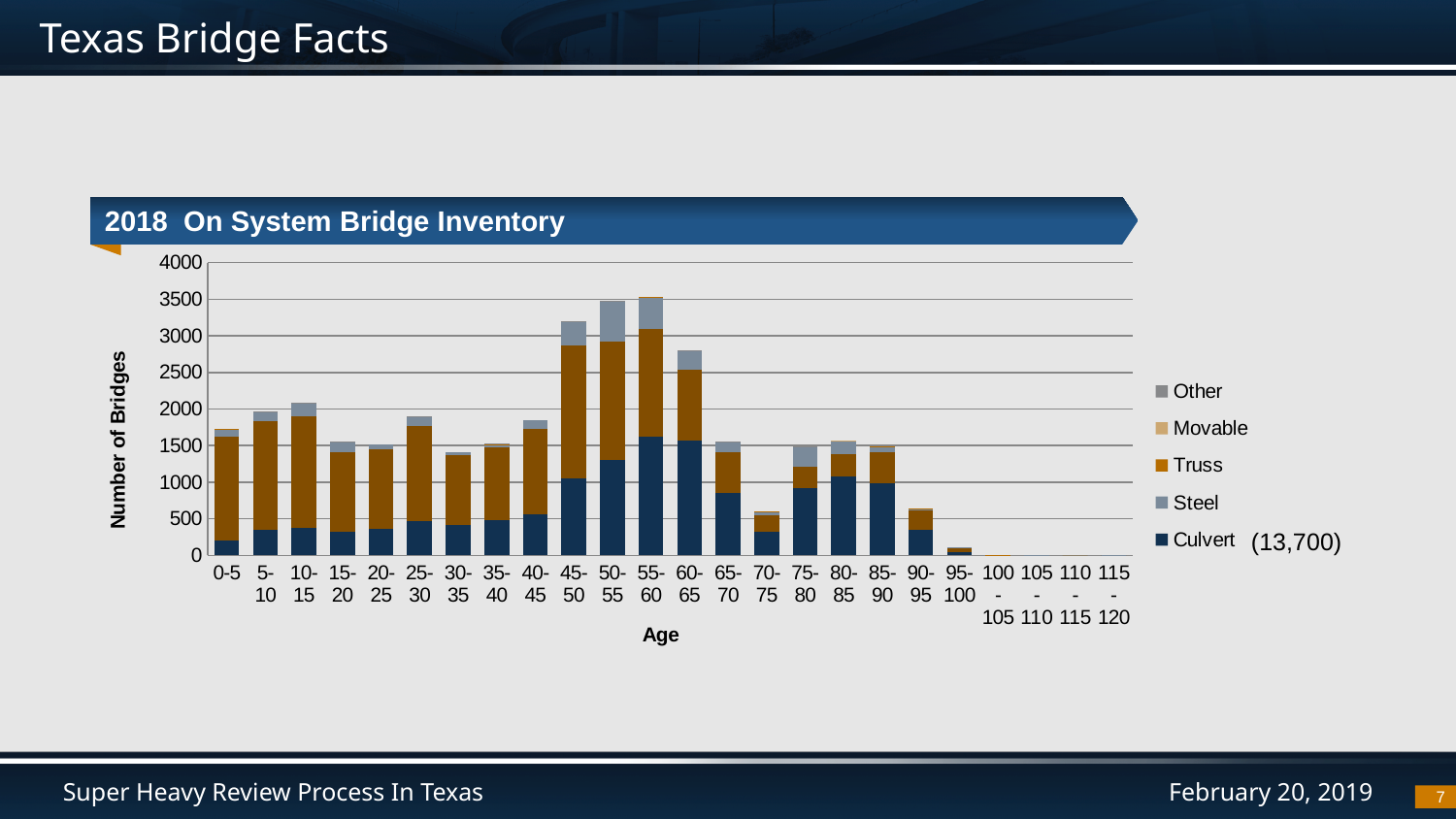
Which age group has the taller total bar, 45-50 or 40-45? 45-50 Is the total number of bridges for the 0-5 age group greater or less than 2000? less How many age categories are shown along the x axis of the bridge inventory chart? 24 Is the total number of bridges for the 70-75 age group greater or less than 1000? less Is the total number of bridges for the 45-50 age group greater or less than 3000? greater Moving from the 60-65 age group to the 75-80 age group, do the total bar heights rise or fall? fall What is the label on the vertical axis of the bridge inventory chart? Number of Bridges How many series does the legend of the bridge inventory chart list? 5 What kind of chart is shown under the title '2018 On System Bridge Inventory'? stacked bar chart Which age group has the taller total bar, 5-10 or 15-20? 5-10 What number is printed next to the Culvert entry in the legend? (13,700)